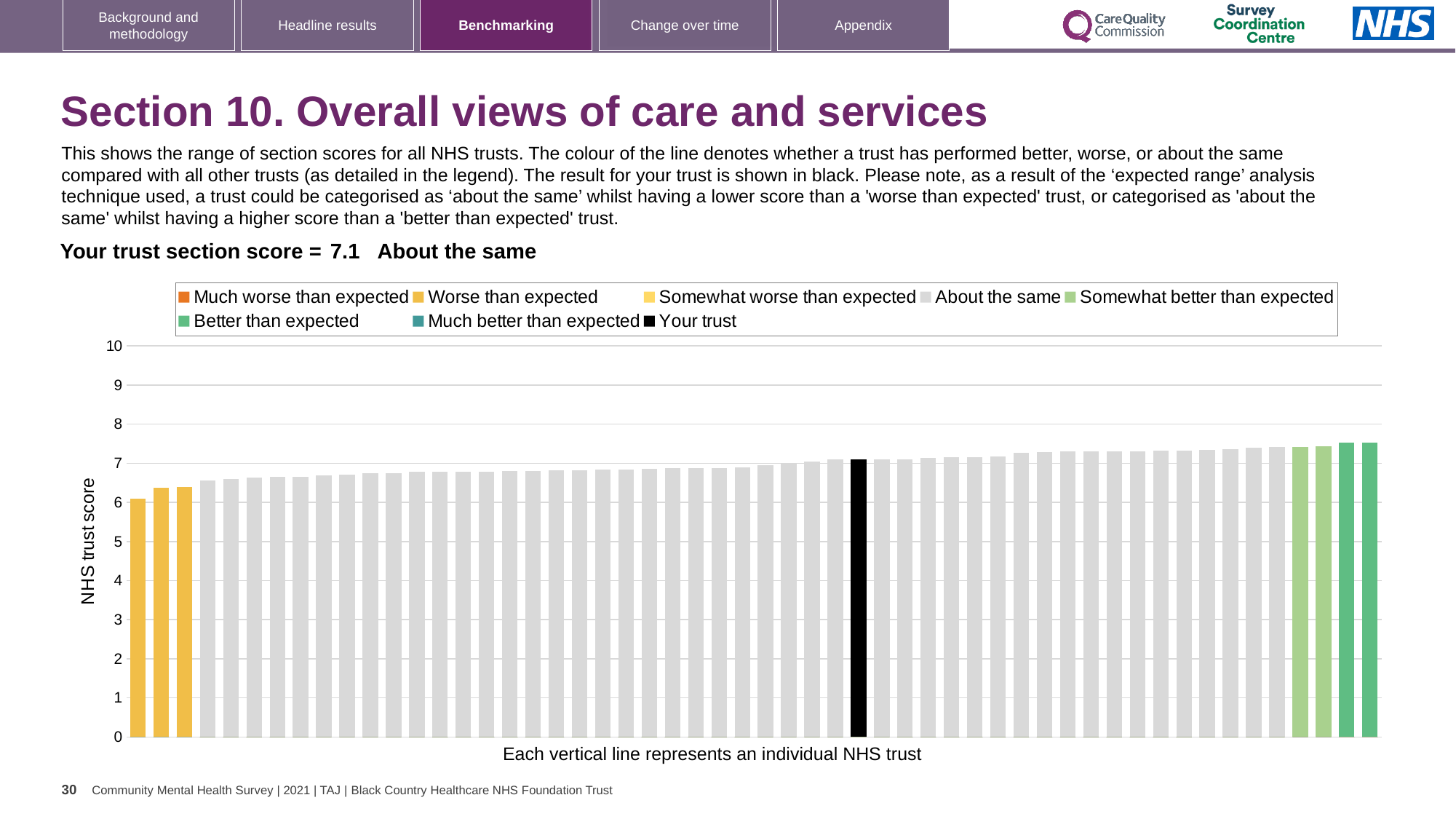
How many entries does the chart legend list? 8 Do the bar values rise or fall from left to right along the x axis? rise Which legend category do the lowest bars on the chart belong to? Worse than expected Which performance category is your trust placed in, according to the text above the chart? About the same What is the title of the vertical axis? NHS trust score What colour is the bar representing your trust? black Is the value of the lowest bar in the chart greater or less than 5? greater Is the value of the highest bar in the chart greater or less than 8? less Which legend category do the highest bars on the chart belong to? Better than expected Is the value of the black 'Your trust' bar greater or less than 7? greater What is your trust's section score as printed on the slide? 7.1 What kind of chart is shown on the slide? bar chart